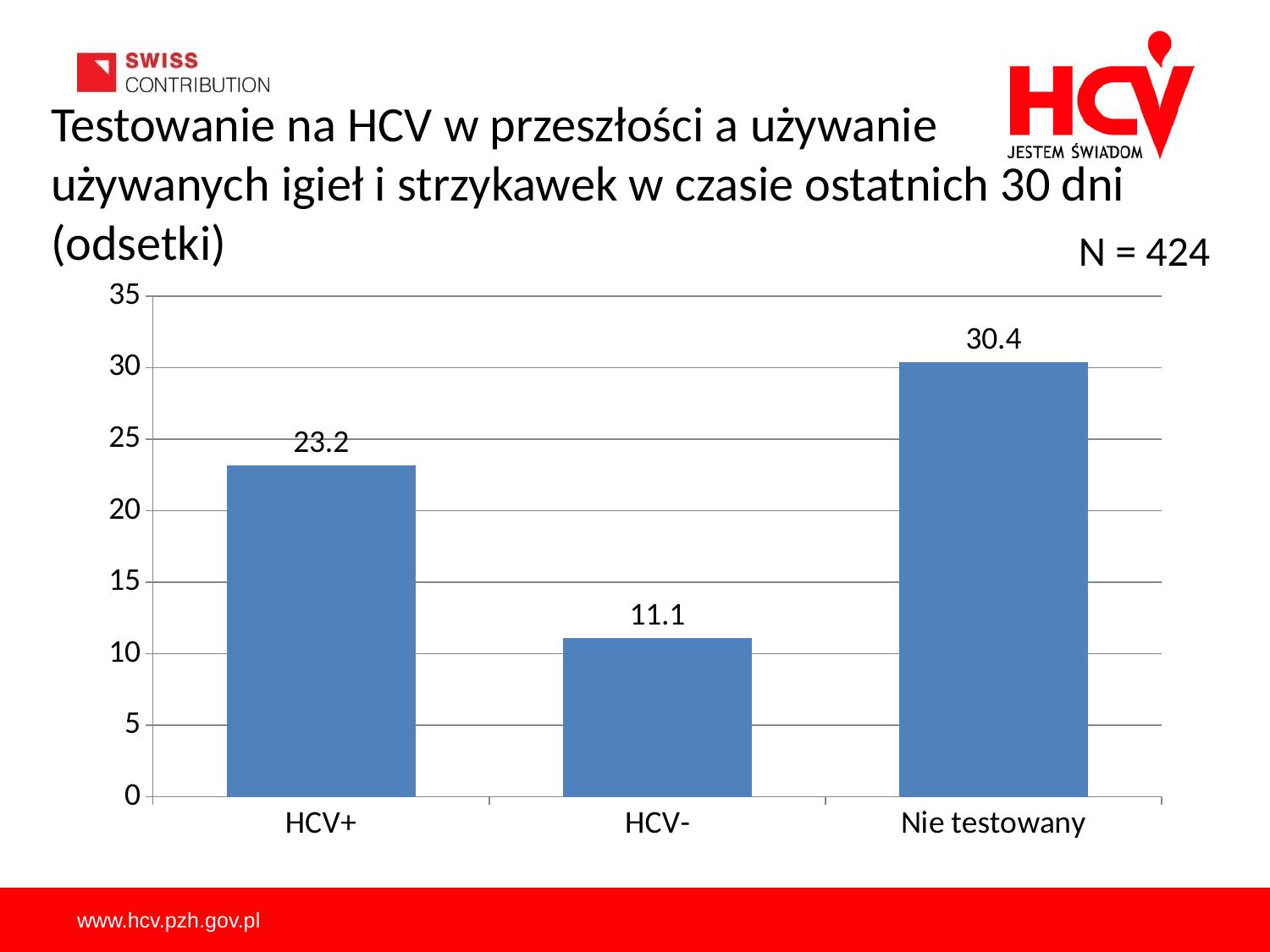
Which is larger, the value for HCV+ or the value for HCV-? HCV+ Which category has the highest value? Nie testowany What is the difference between the values for Nie testowany and HCV+? 7.2 What sample size (N) is stated on the slide? N = 424 Which category has the lowest value? HCV- What is the value for Nie testowany? 30.4 How many categories are shown on the x axis? 3 What is the value for HCV+? 23.2 What is the value for HCV-? 11.1 What is the difference between the values for HCV+ and HCV-? 12.1 What kind of chart is shown on the slide? bar chart Is the value for Nie testowany greater or less than 30? greater